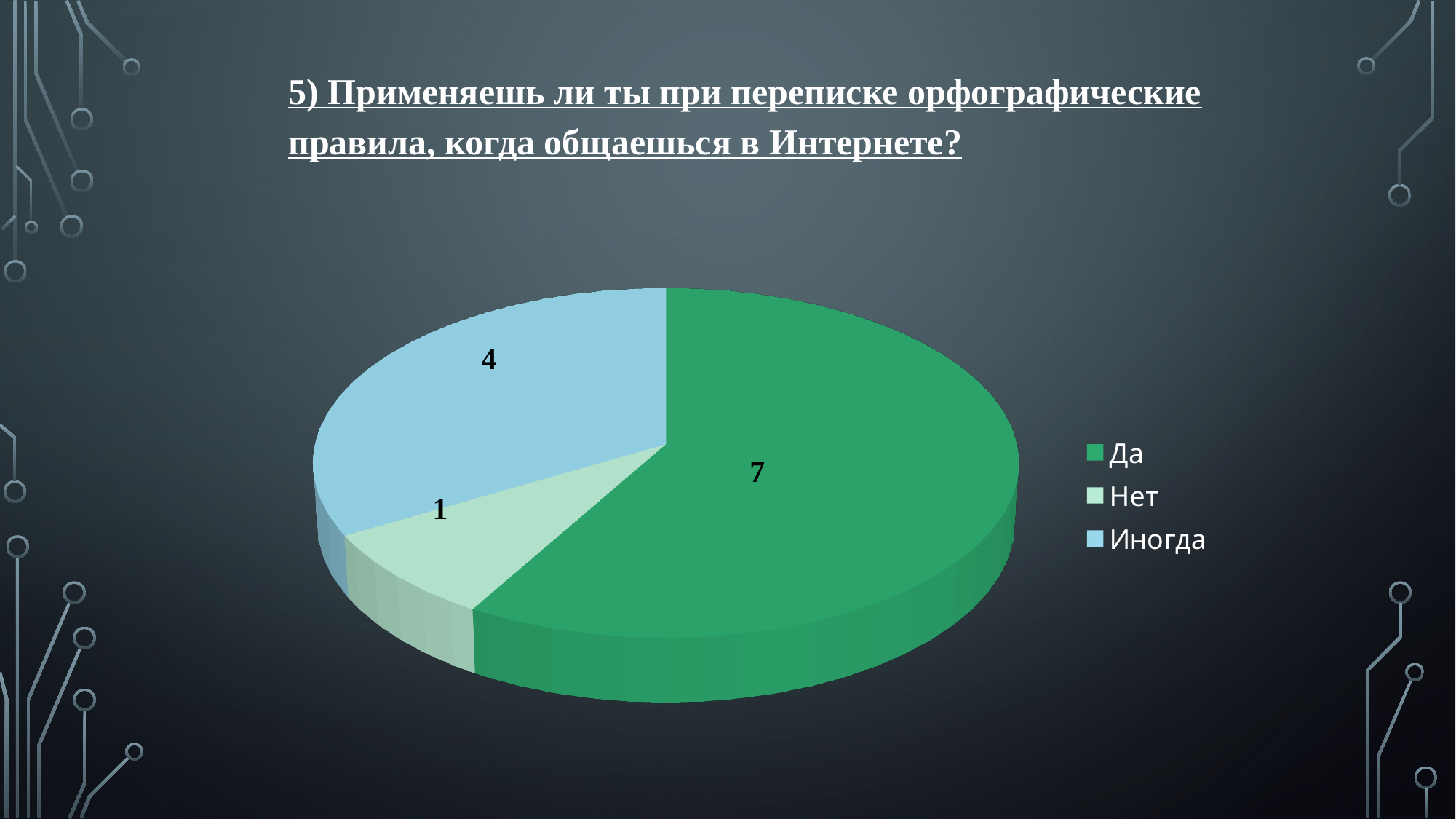
What is the value for "Нет"? 1 What kind of chart is shown on the slide? pie chart What is the difference between the values for "Да" and "Иногда"? 3 Which category has the largest slice? Да How many categories does the pie chart have? 3 What colour is the "Иногда" slice? light blue What is the value for "Иногда"? 4 What is the total of all slices in the pie chart? 12 What is the value for "Да"? 7 Which category has the smallest slice? Нет What share of the pie does "Нет" represent? 1/12 Which is larger, the value for "Иногда" or the value for "Нет"? Иногда